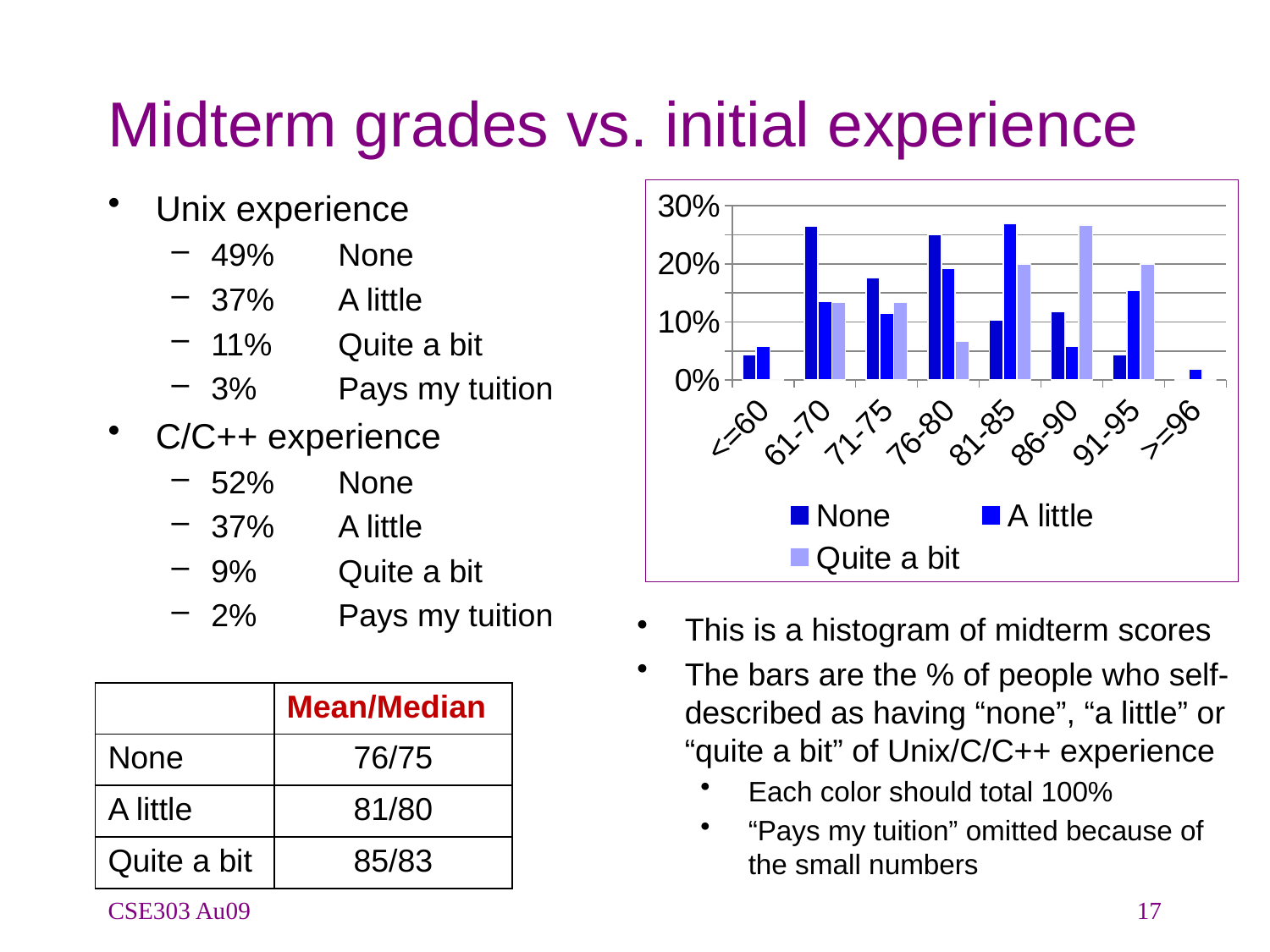
In the 86-90 range, which is larger: the "Quite a bit" bar or the "None" bar? Quite a bit In the 61-70 range, which is larger: the "None" bar or the "Quite a bit" bar? None Is the value for "None" in the 61-70 range greater or less than 20%? greater How many score ranges are shown along the x axis of the chart? 8 How many series does the chart's legend list? 3 What kind of chart is shown on the slide? bar chart Is the value for "Quite a bit" in the 86-90 range greater or less than 20%? greater Is the value for "None" in the <=60 range greater or less than 10%? less In which score range is the "Quite a bit" series highest? 86-90 Which series are listed in the chart's legend? None, A little, Quite a bit